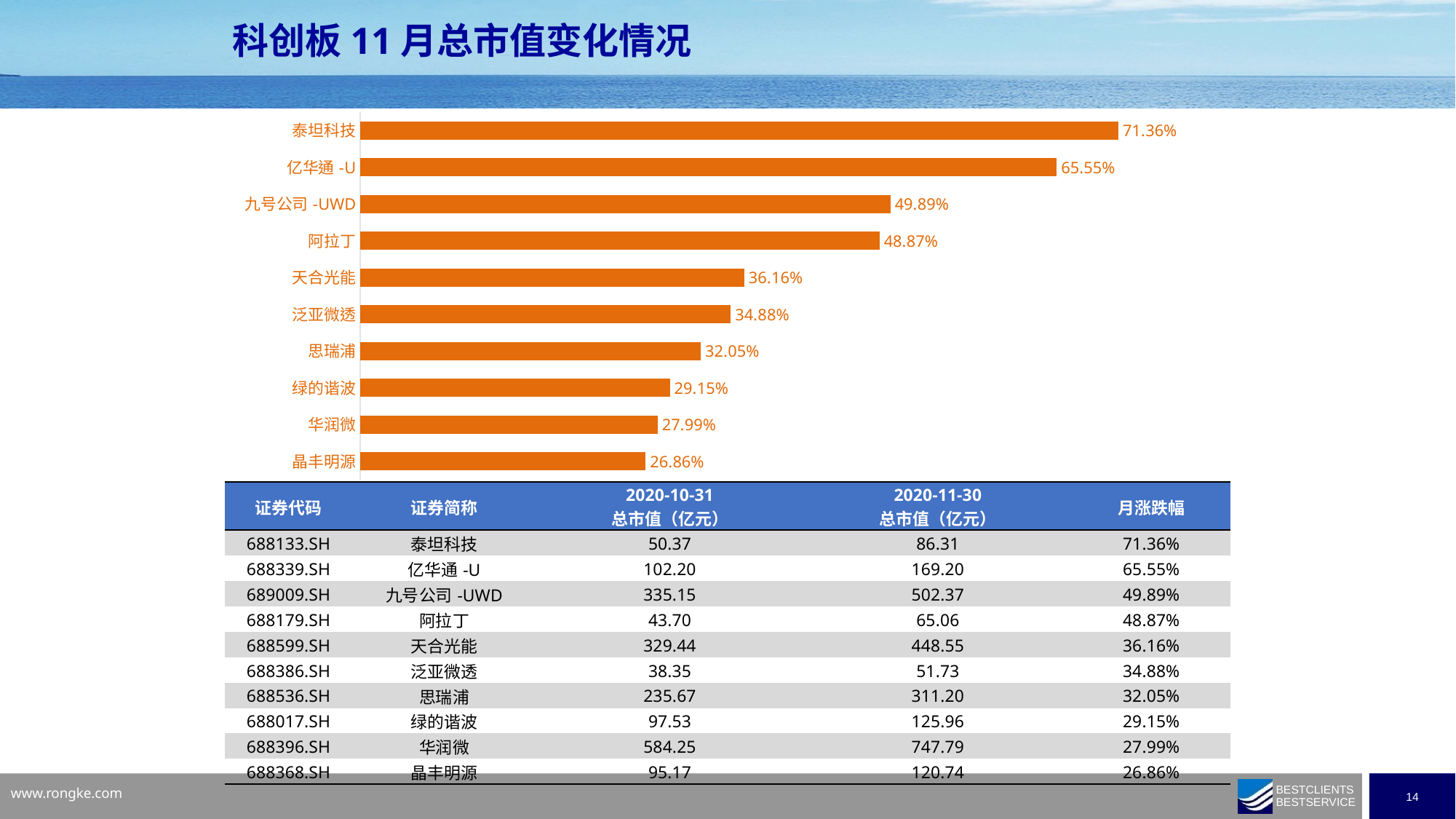
Which company has the lowest value in the bar chart? 晶丰明源 What is the difference between the values for 九号公司 -UWD and 阿拉丁? 1.02% Do the bar values increase or decrease from the top bar to the bottom bar? decrease Which company has the highest value in the bar chart? 泰坦科技 What is the value shown for 泰坦科技 in the bar chart? 71.36% What kind of chart is shown on the slide? bar chart How many companies are shown in the bar chart? 10 Which is larger, the value for 泛亚微透 or the value for 思瑞浦? 泛亚微透 What colour are the bars in the chart? orange What is the value shown for 晶丰明源 in the bar chart? 26.86% What is the difference between the values for 泰坦科技 and 亿华通 -U? 5.81% What is the value shown for 天合光能 in the bar chart? 36.16%